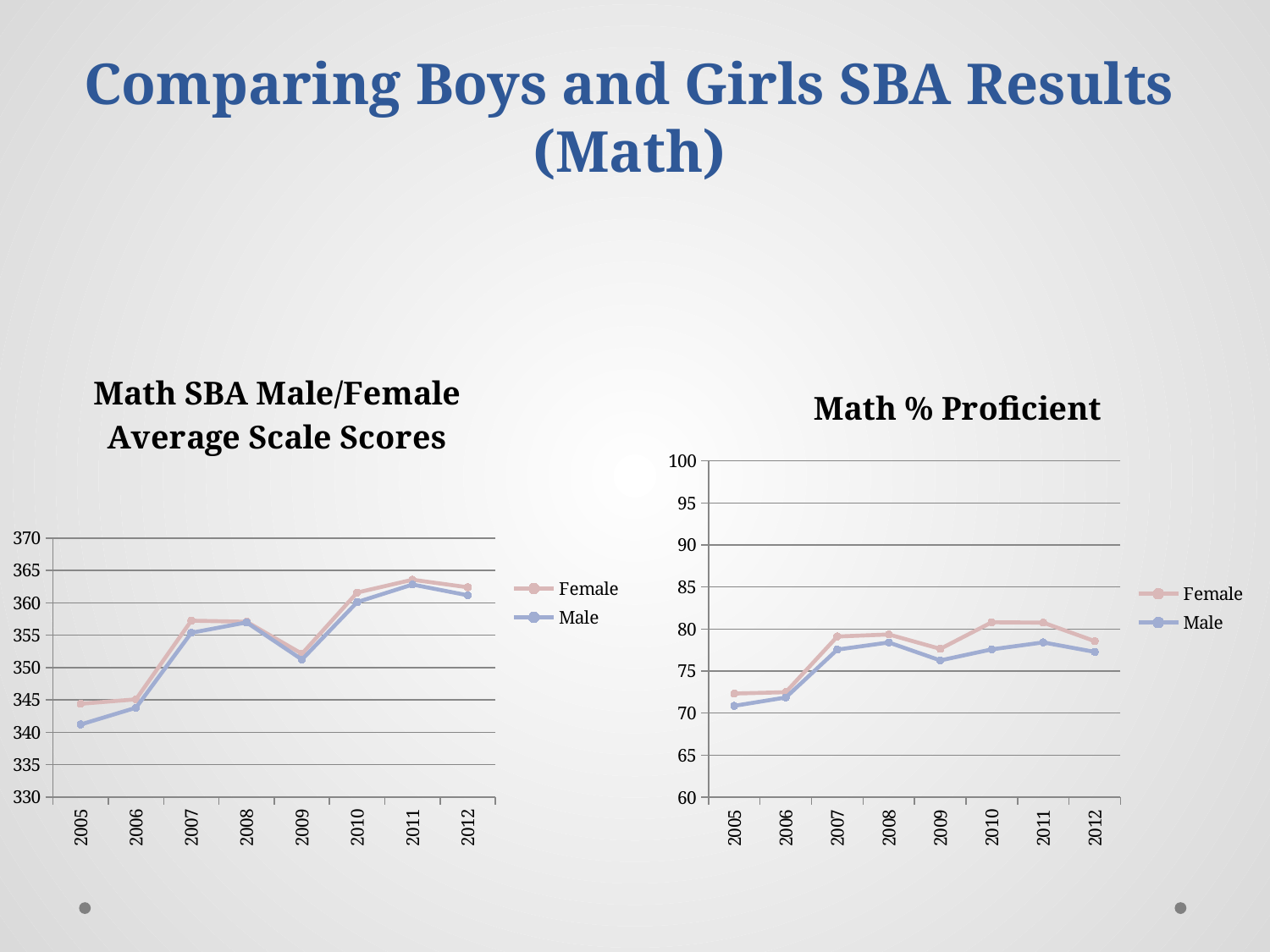
In the 'Math SBA Male/Female Average Scale Scores' chart, does the Male series rise or fall from 2005 to 2007? rise In the 'Math % Proficient' chart, is the Male value for 2005 greater or less than 75? less In the 'Math SBA Male/Female Average Scale Scores' chart, how many years are shown on the x axis? 8 In the 'Math SBA Male/Female Average Scale Scores' chart, in which year is the Female series lowest? 2005 What are the two legend entries in the 'Math % Proficient' chart? Female and Male In the 'Math SBA Male/Female Average Scale Scores' chart, is the Male value for 2005 greater or less than 345? less In the 'Math % Proficient' chart, is the Female value for 2010 greater or less than 80? greater In the 'Math % Proficient' chart on the right, how many series does the legend list? 2 In the 'Math % Proficient' chart, which series has the higher value in 2010, Female or Male? Female What kind of chart is the 'Math SBA Male/Female Average Scale Scores' chart on the left? line chart In the 'Math SBA Male/Female Average Scale Scores' chart, in which year is the Male series highest? 2011